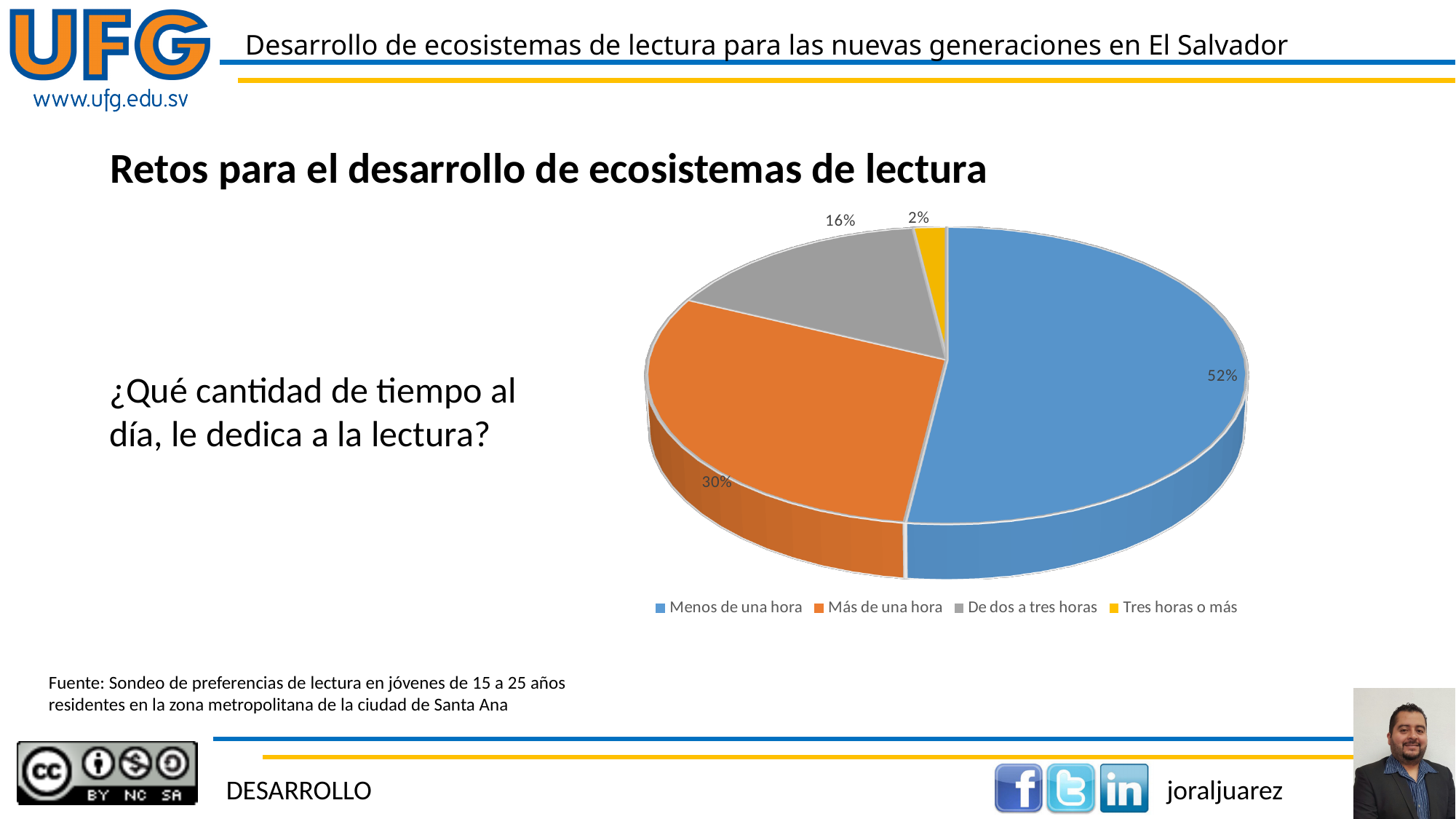
What colour is the slice for 'Más de una hora'? Orange What percentage corresponds to 'Tres horas o más'? 2% Which category has the largest share of the pie? Menos de una hora Which is larger, the share for 'De dos a tres horas' or the share for 'Tres horas o más'? De dos a tres horas Which category has the smallest share of the pie? Tres horas o más What question does the chart answer, according to the text on the slide? ¿Qué cantidad de tiempo al día, le dedica a la lectura? What is the difference in percentage points between 'Menos de una hora' and 'Más de una hora'? 22 What kind of chart is shown on the slide? Pie chart What percentage corresponds to 'De dos a tres horas'? 16% What percentage of respondents read 'Menos de una hora' per day? 52% What percentage corresponds to 'Más de una hora'? 30% How many categories does the pie chart have? 4